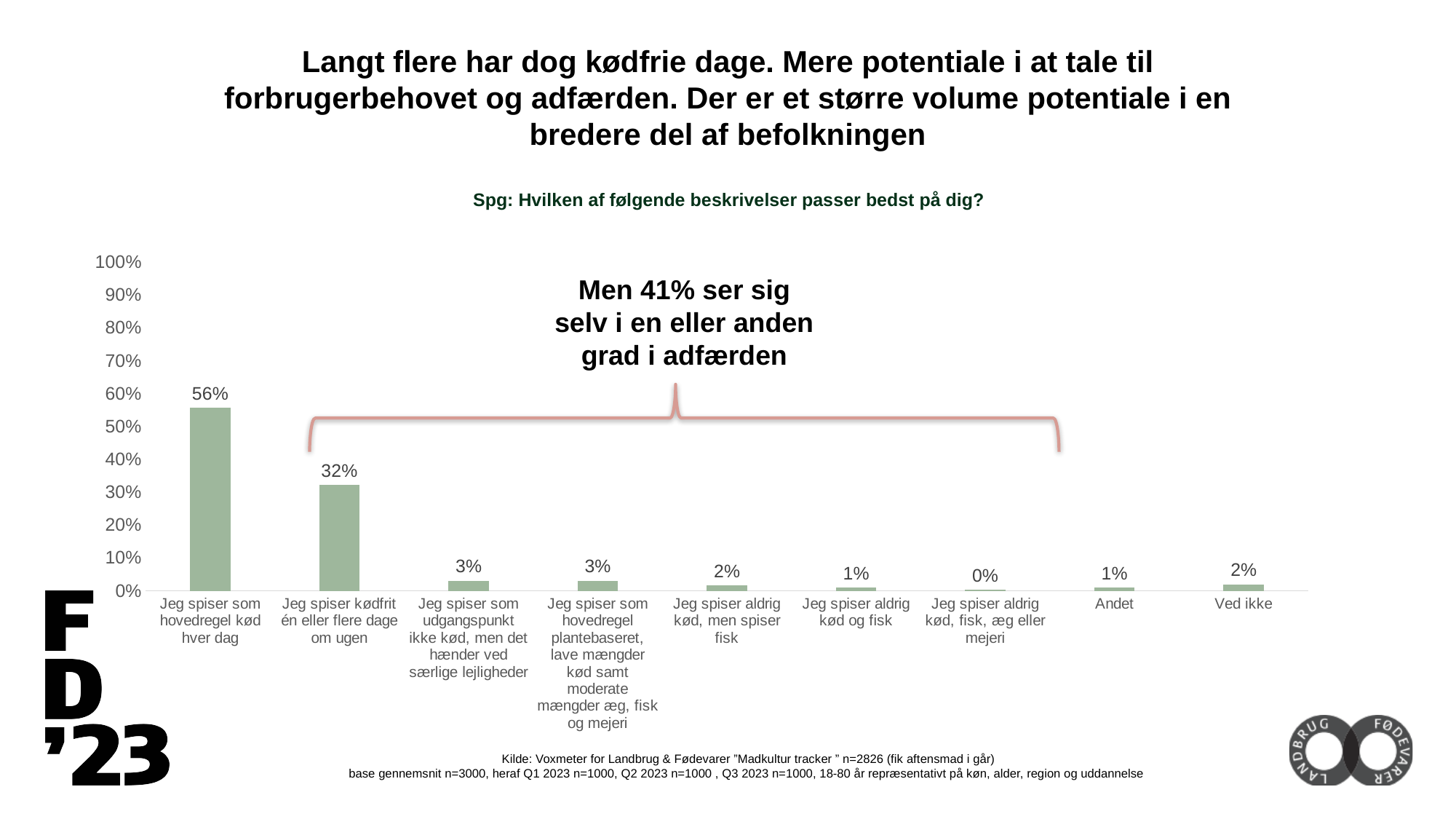
Which category has the lowest value? Jeg spiser aldrig kød, fisk, æg eller mejeri Which is larger: the value for "Ved ikke" or the value for "Andet"? Ved ikke According to the annotation above the bracket, what share of respondents see themselves in the behaviour to some degree? 41% What percentage of respondents answered "Jeg spiser som hovedregel kød hver dag"? 56% What is the value for "Jeg spiser aldrig kød, fisk, æg eller mejeri"? 0% What is the value for "Jeg spiser kødfrit én eller flere dage om ugen"? 32% How many categories are shown on the x axis? 9 What kind of chart is shown on the slide? Bar chart What is the difference between "Jeg spiser som hovedregel kød hver dag" and "Jeg spiser kødfrit én eller flere dage om ugen"? 24 percentage points Is the value for "Jeg spiser som hovedregel kød hver dag" greater or less than 50%? greater What is the value for "Jeg spiser aldrig kød, men spiser fisk"? 2% Which category has the highest value? Jeg spiser som hovedregel kød hver dag